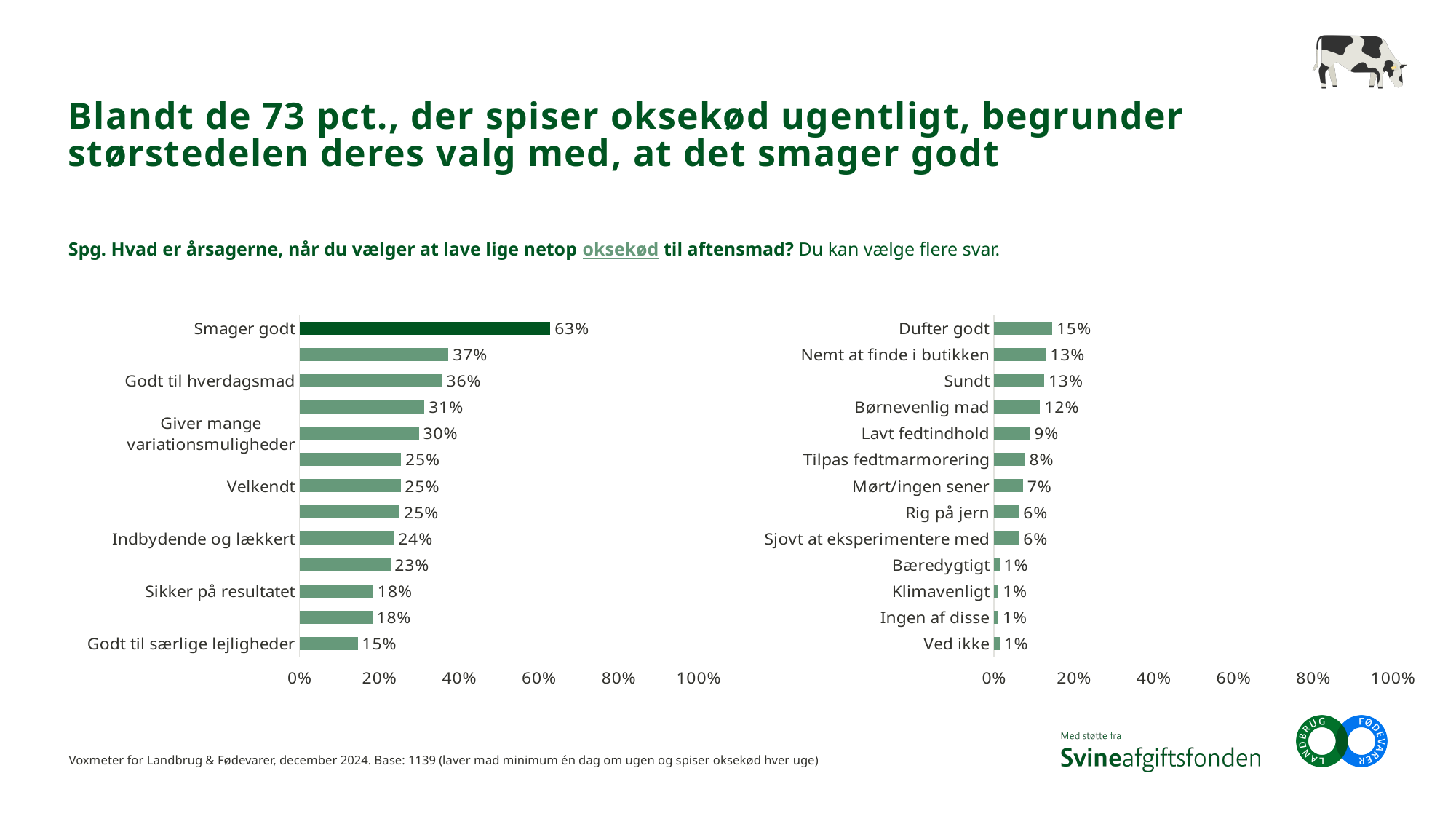
In the left chart, what is the value for Godt til hverdagsmad? 36% In the right chart, what is the difference between Mørt/ingen sener and Rig på jern? 1 percentage point What kind of chart is shown on the left of the slide? Bar chart In the right chart, what is the value for Børnevenlig mad? 12% How many bars does the right chart show? 13 In the left chart, what is the difference between Smager godt and Godt til hverdagsmad? 27 percentage points In the left chart, what is the value for Smager godt? 63% In the left chart, is the value for Velkendt greater or less than 20%? greater In the right chart, which is larger: Dufter godt or Sundt? Dufter godt In the right chart, what is the value for Lavt fedtindhold? 9% In the right chart, which category has the highest value? Dufter godt In the left chart, which labelled category has the lowest value? Godt til særlige lejligheder